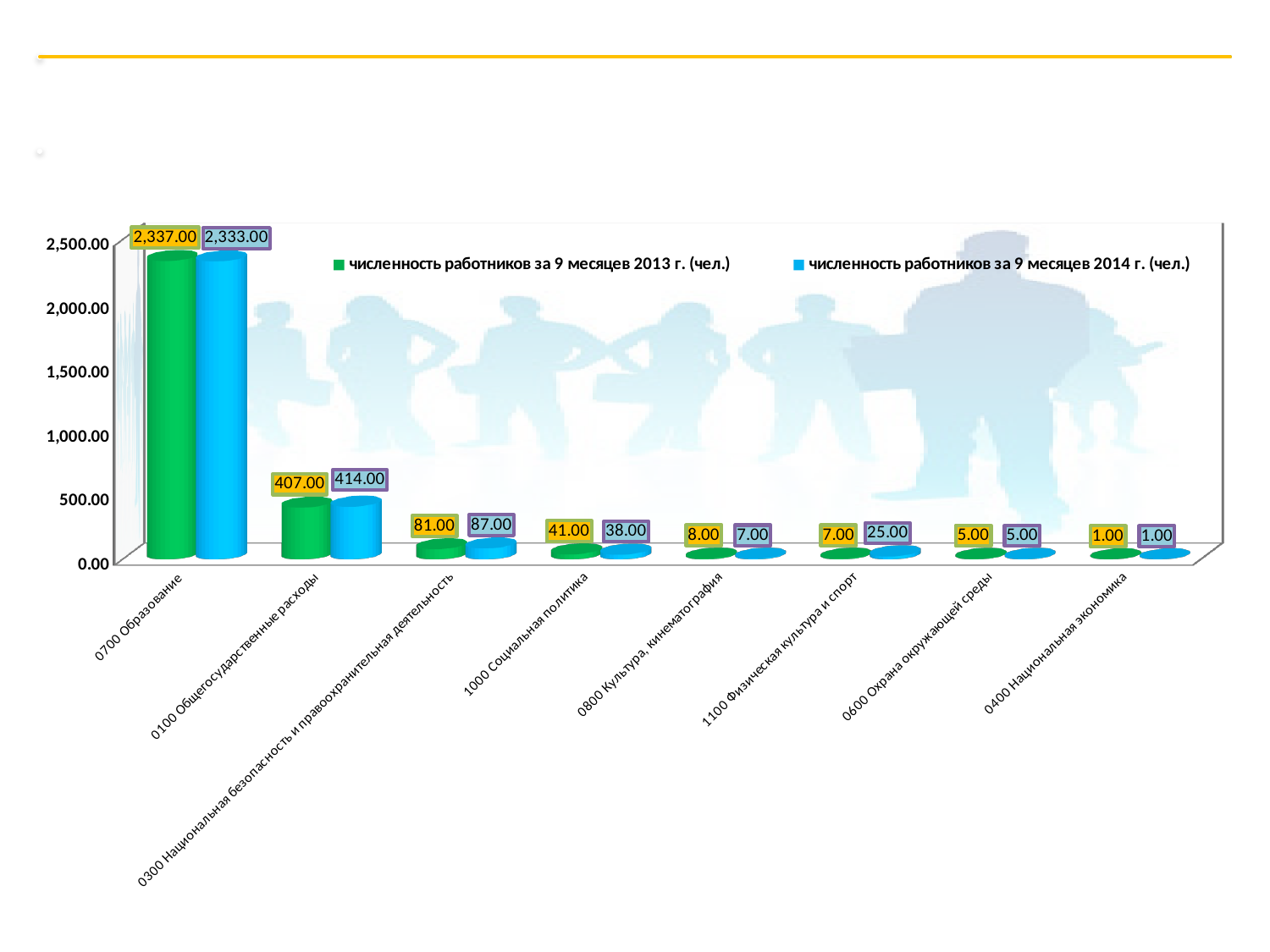
For 1100 Физическая культура и спорт, which series has the larger value: 2013 or 2014? численность работников за 9 месяцев 2014 г. (чел.) What is the value for 0700 Образование in the series численность работников за 9 месяцев 2013 г. (чел.)? 2,337.00 How many categories are shown on the x axis? 8 What kind of chart is shown on the slide? bar chart What is the value for 1100 Физическая культура и спорт in the series численность работников за 9 месяцев 2014 г. (чел.)? 25.00 Is the value for 0100 Общегосударственные расходы in the 2013 series greater or less than 500.00? less Which category has the lowest value in the series численность работников за 9 месяцев 2013 г. (чел.)? 0400 Национальная экономика What is the value for 0100 Общегосударственные расходы in the series численность работников за 9 месяцев 2014 г. (чел.)? 414.00 What is the value for 1000 Социальная политика in the series численность работников за 9 месяцев 2013 г. (чел.)? 41.00 How many series does the legend list? 2 Which category has the highest value in the series численность работников за 9 месяцев 2014 г. (чел.)? 0700 Образование What is the difference between the 2013 and 2014 values for 0300 Национальная безопасность и правоохранительная деятельность? 6.00